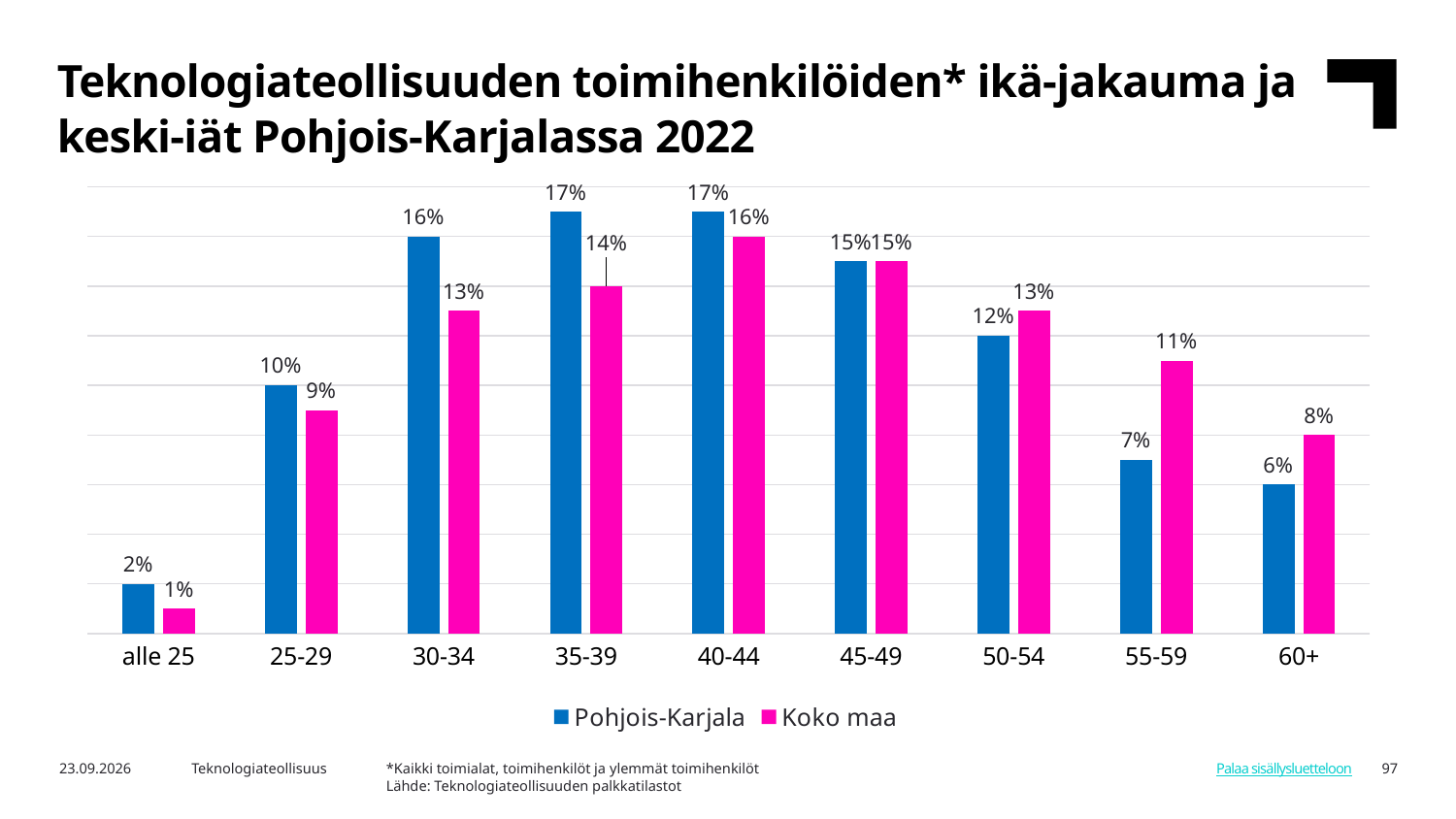
Which age group has the lowest value for Pohjois-Karjala? alle 25 In the 50-54 age group, which series has the larger value, Pohjois-Karjala or Koko maa? Koko maa What is the value for Pohjois-Karjala in the 60+ age group? 6% What kind of chart is shown on the slide? Bar chart In the 25-29 age group, which series has the larger value, Pohjois-Karjala or Koko maa? Pohjois-Karjala What is the value for Pohjois-Karjala in the 30-34 age group? 16% What is the difference between Pohjois-Karjala and Koko maa in the 35-39 age group? 3 percentage points What is the value for Koko maa in the 55-59 age group? 11% Do the Koko maa values rise or fall from the 45-49 age group to the 60+ age group? Fall How many series does the legend list? 2 How many age groups are shown on the x axis? 9 Which age group has the highest value for Koko maa? 40-44